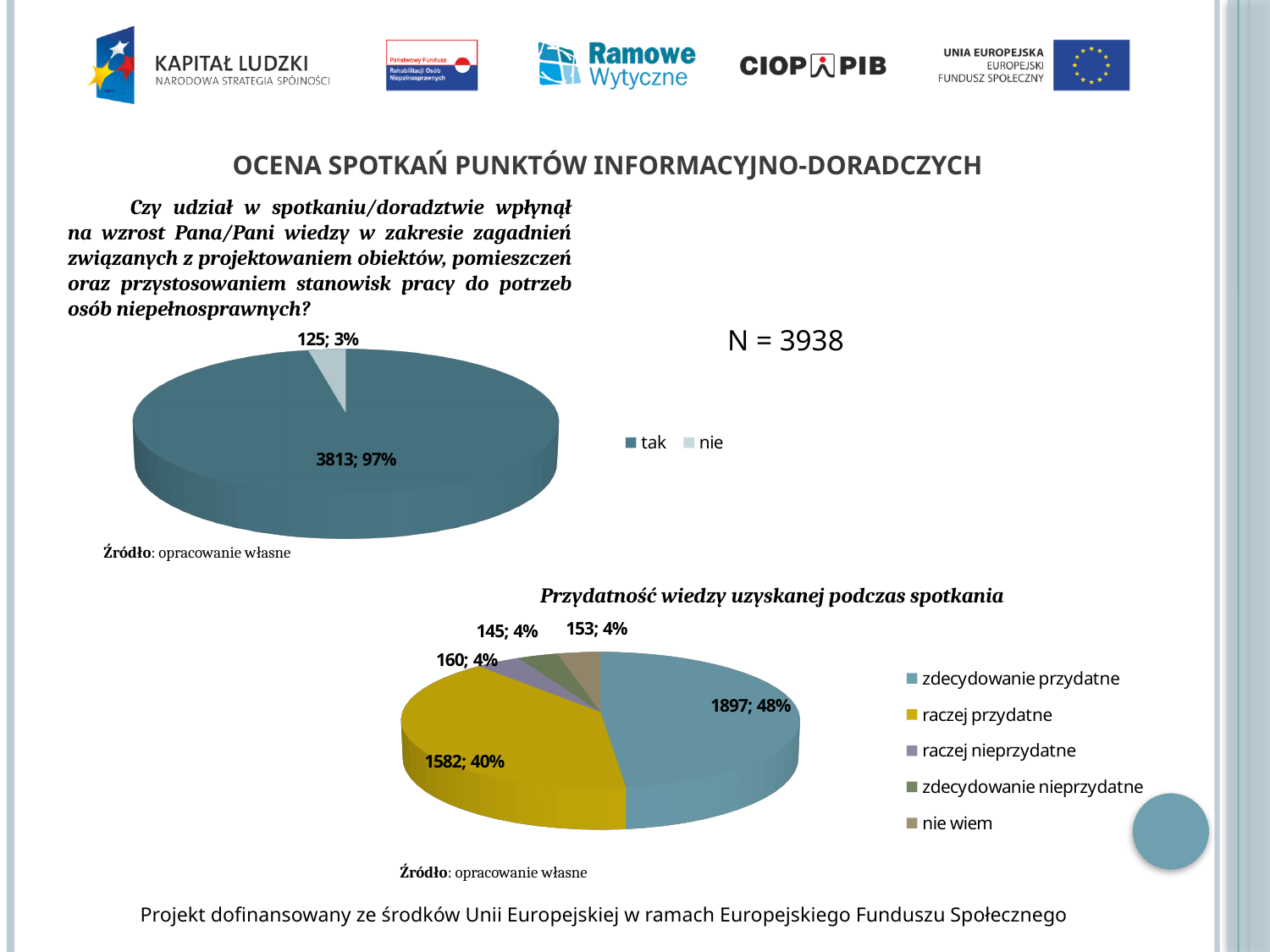
In the top pie chart, what percentage share does "nie" have? 3% What kind of chart is the top chart on the slide? Pie chart In the top pie chart, what is the difference between the counts for "tak" and "nie"? 3688 In the chart titled "Przydatność wiedzy uzyskanej podczas spotkania", which is larger: the count for "nie wiem" or for "zdecydowanie nieprzydatne"? nie wiem In the chart titled "Przydatność wiedzy uzyskanej podczas spotkania", how many respondents chose "zdecydowanie przydatne"? 1897 In the top pie chart, how many respondents answered "tak"? 3813 In the chart titled "Przydatność wiedzy uzyskanej podczas spotkania", what percentage share does "raczej przydatne" have? 40% In the chart titled "Przydatność wiedzy uzyskanej podczas spotkania", which category has the highest count? zdecydowanie przydatne In the chart titled "Przydatność wiedzy uzyskanej podczas spotkania", what is the difference between the counts for "zdecydowanie przydatne" and "raczej przydatne"? 315 In the chart titled "Przydatność wiedzy uzyskanej podczas spotkania", which category has the lowest count? zdecydowanie nieprzydatne How many series does the legend of the top pie chart list? 2 In the chart titled "Przydatność wiedzy uzyskanej podczas spotkania", how many categories does the legend list? 5